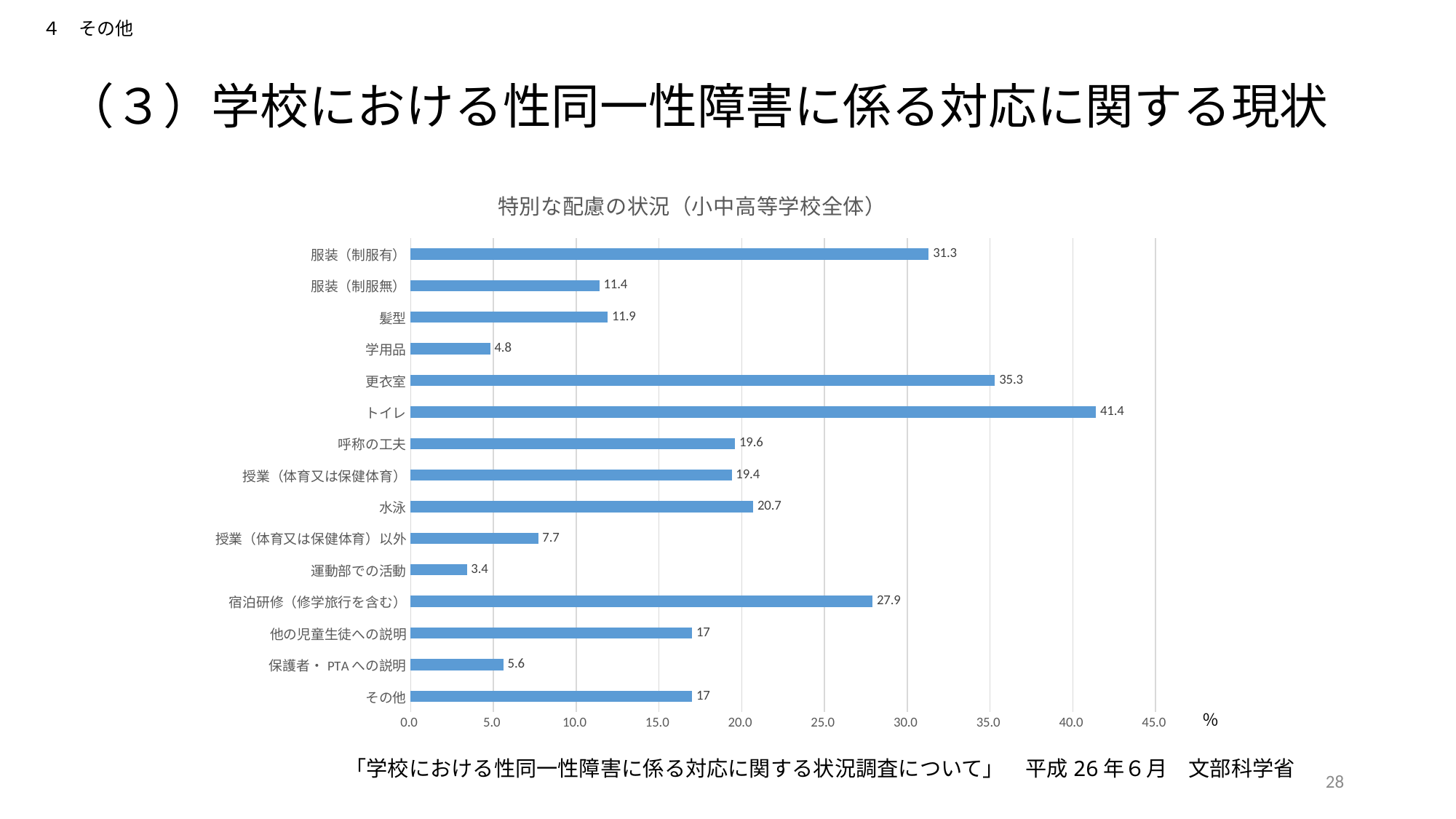
Which category has the highest value? トイレ What kind of chart is shown on the slide? bar chart Is the value for 更衣室 greater or less than 30.0? greater What is the difference between the values for トイレ and 更衣室? 6.1 Which is larger, the value for 服装（制服有） or the value for 宿泊研修（修学旅行を含む）? 服装（制服有） Which category has the lowest value? 運動部での活動 What is the value for トイレ? 41.4 What is the value for 更衣室? 35.3 What is the value for 学用品? 4.8 How many categories are shown in the chart? 15 What is the title of the chart? 特別な配慮の状況（小中高等学校全体） What is the value for 宿泊研修（修学旅行を含む）? 27.9